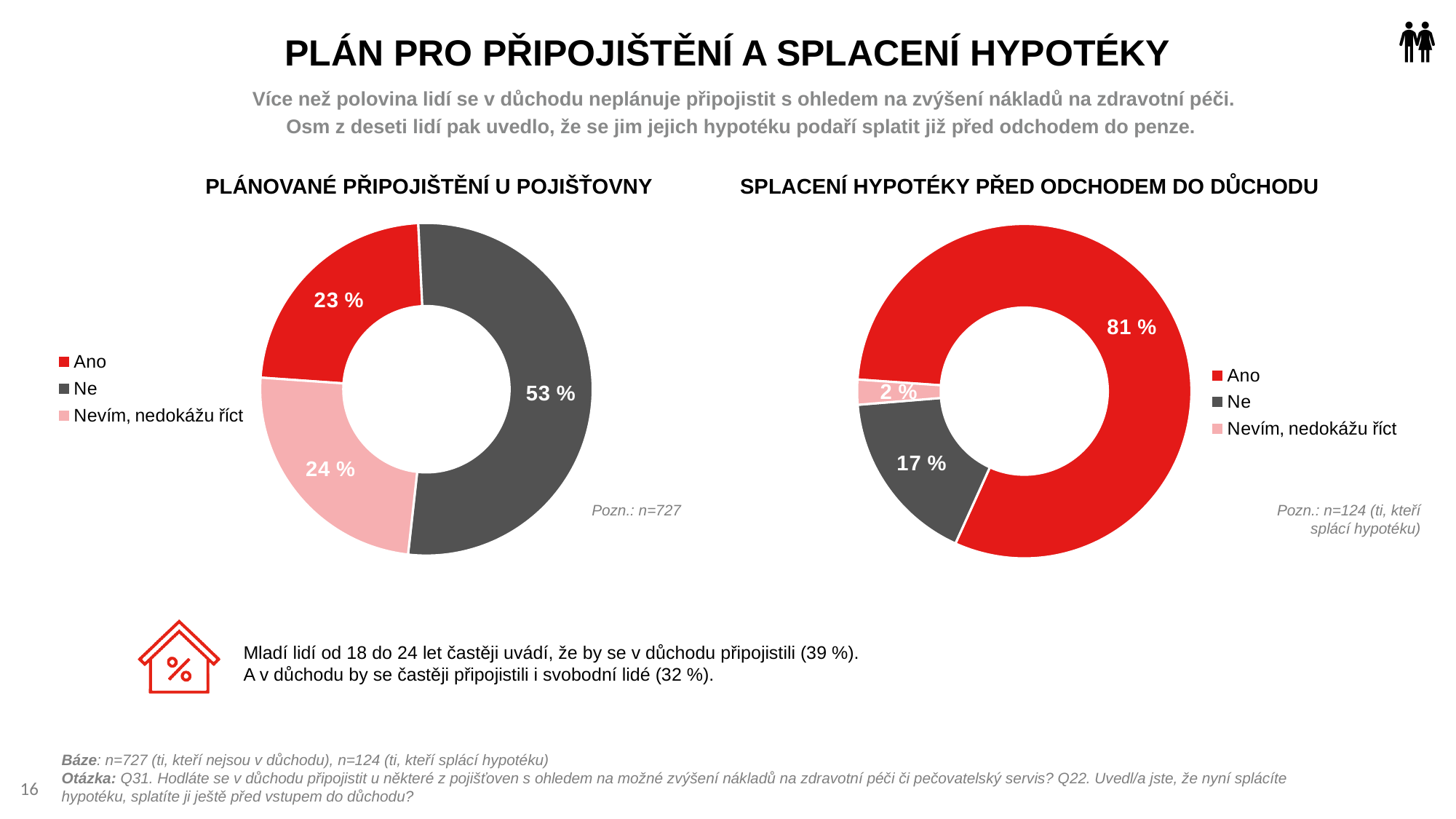
In the chart 'PLÁNOVANÉ PŘIPOJIŠTĚNÍ U POJIŠŤOVNY', which category has the largest share? Ne In the chart 'PLÁNOVANÉ PŘIPOJIŠTĚNÍ U POJIŠŤOVNY', what is the value for 'Ne'? 53 % In the chart 'SPLACENÍ HYPOTÉKY PŘED ODCHODEM DO DŮCHODU', what is the value for 'Nevím, nedokážu říct'? 2 % In the chart 'SPLACENÍ HYPOTÉKY PŘED ODCHODEM DO DŮCHODU', what is the difference between 'Ano' and 'Ne'? 64 % In the chart 'PLÁNOVANÉ PŘIPOJIŠTĚNÍ U POJIŠŤOVNY', what is the value for 'Ano'? 23 % In the chart 'SPLACENÍ HYPOTÉKY PŘED ODCHODEM DO DŮCHODU', what is the value for 'Ano'? 81 % What kind of chart is 'SPLACENÍ HYPOTÉKY PŘED ODCHODEM DO DŮCHODU'? Doughnut (pie) chart In the chart 'PLÁNOVANÉ PŘIPOJIŠTĚNÍ U POJIŠŤOVNY', what is the value for 'Nevím, nedokážu říct'? 24 % In the chart 'SPLACENÍ HYPOTÉKY PŘED ODCHODEM DO DŮCHODU', which category has the smallest share? Nevím, nedokážu říct How many categories does the legend of the chart 'PLÁNOVANÉ PŘIPOJIŠTĚNÍ U POJIŠŤOVNY' list? 3 In the chart 'PLÁNOVANÉ PŘIPOJIŠTĚNÍ U POJIŠŤOVNY', which is larger, 'Ano' or 'Ne'? Ne In the chart 'SPLACENÍ HYPOTÉKY PŘED ODCHODEM DO DŮCHODU', what is the value for 'Ne'? 17 %